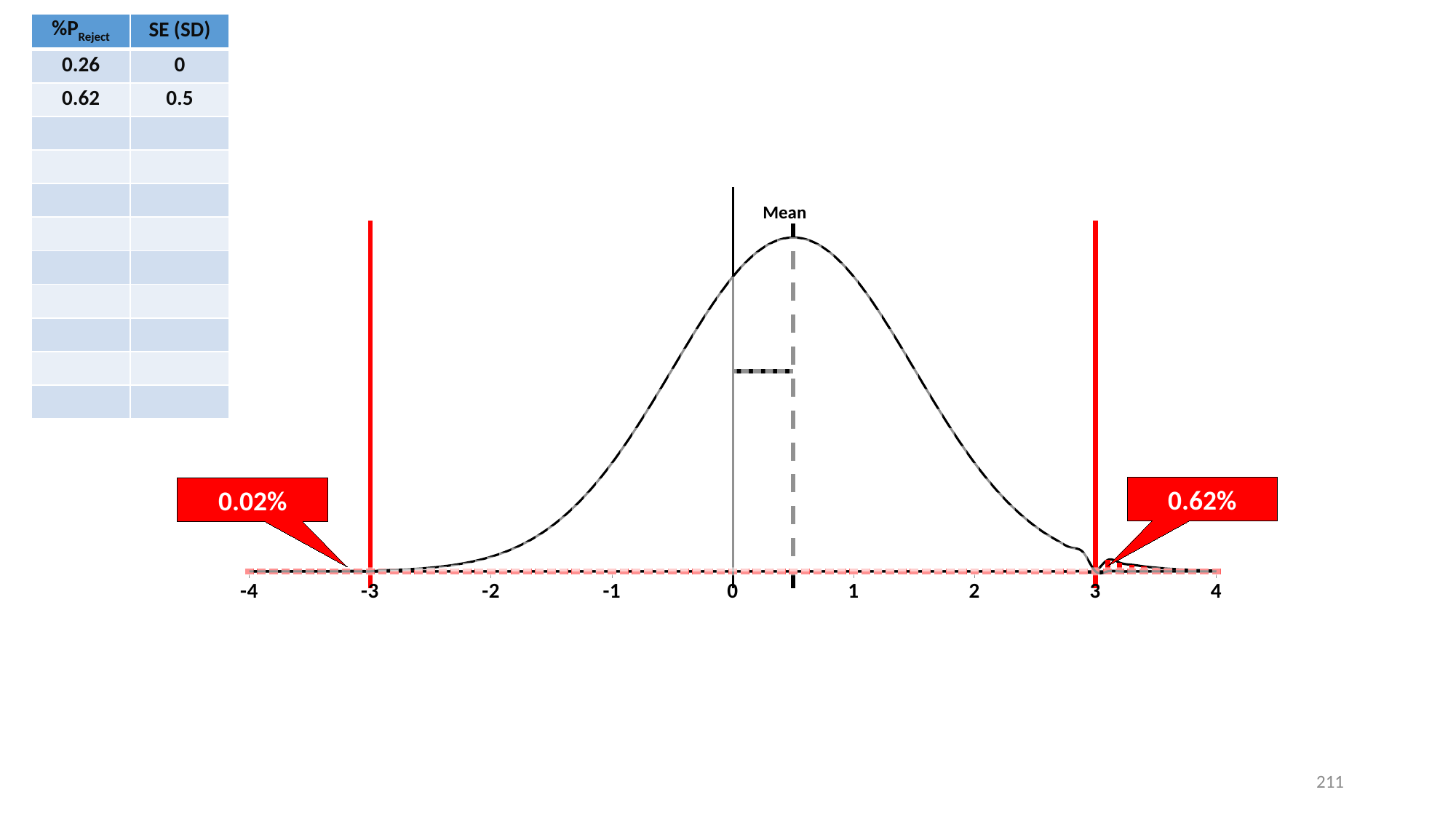
What is the lowest value labelled on the x axis? -4 Which callout shows the larger value, the one at x = -3 or the one at x = 3? the one at x = 3 (0.62%) What label is written at the peak of the curve? Mean What colour are the two vertical lines drawn at x = -3 and x = 3? red What is the difference between the two callout values, 0.62% and 0.02%? 0.60% Does the curve rise or fall as x goes from 1 to 3? fall What is the highest value labelled on the x axis? 4 What kind of chart is shown on the slide? line chart What value does the callout at the right red vertical line (x = 3) show? 0.62% What value does the callout at the left red vertical line (x = -3) show? 0.02% How many tick labels are shown on the x axis? 9 Does the curve rise or fall as x goes from -3 to 0? rise